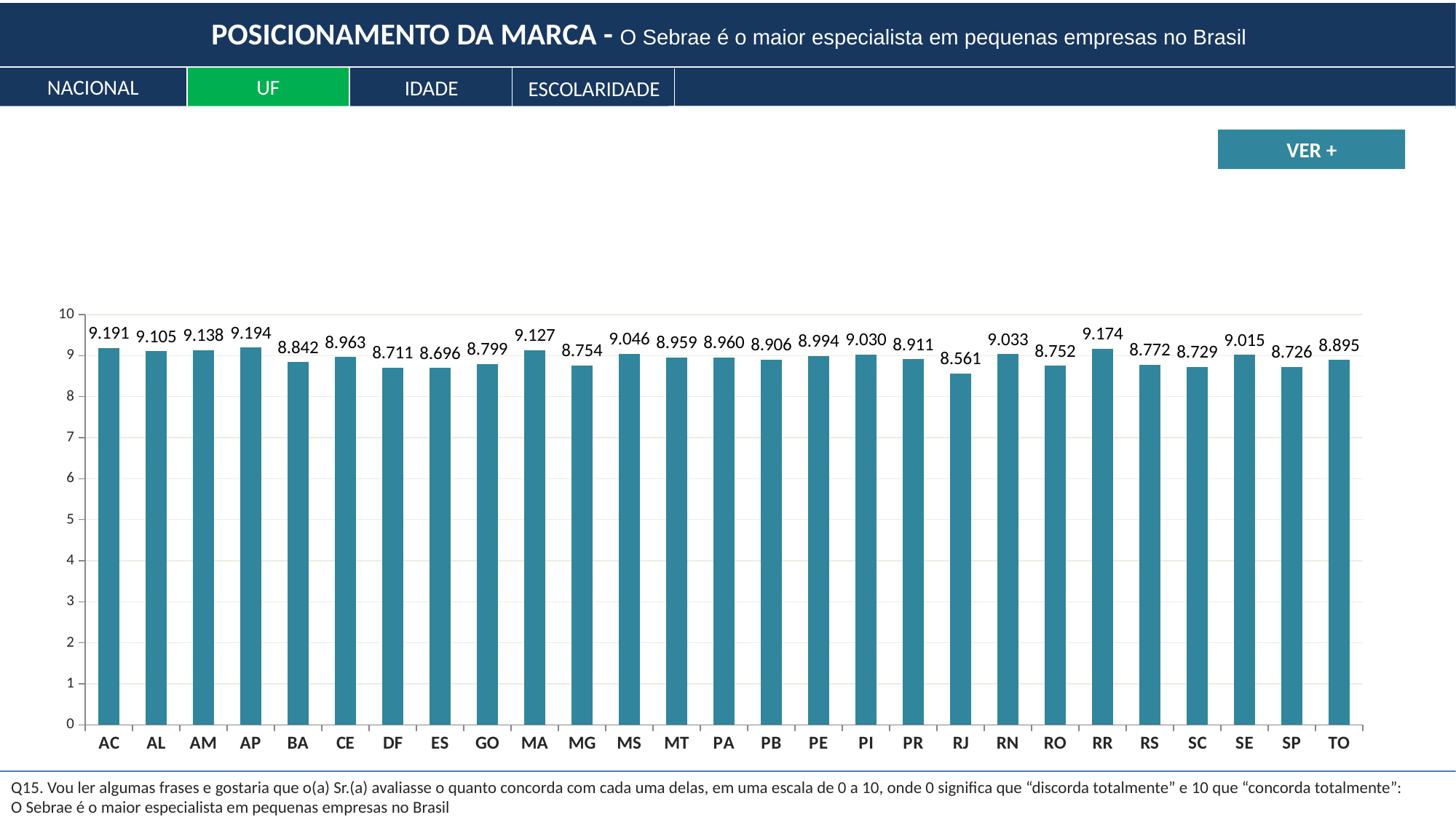
Which tab is highlighted in green at the top of the slide? UF How many states (UF) are shown on the x axis? 27 Which state has the highest value according to the data labels? AP What is the value for RR? 9.174 Is the value for RJ greater or less than 9? less What is the difference between the values for CE and BA? 0.121 What is the value for SP? 8.726 What kind of chart is shown on the slide? bar chart Which state has the lowest value? RJ What is the value for MA? 9.127 What is the difference between the values for AP and RJ? 0.633 Which is larger, the value for MS or the value for MG? MS